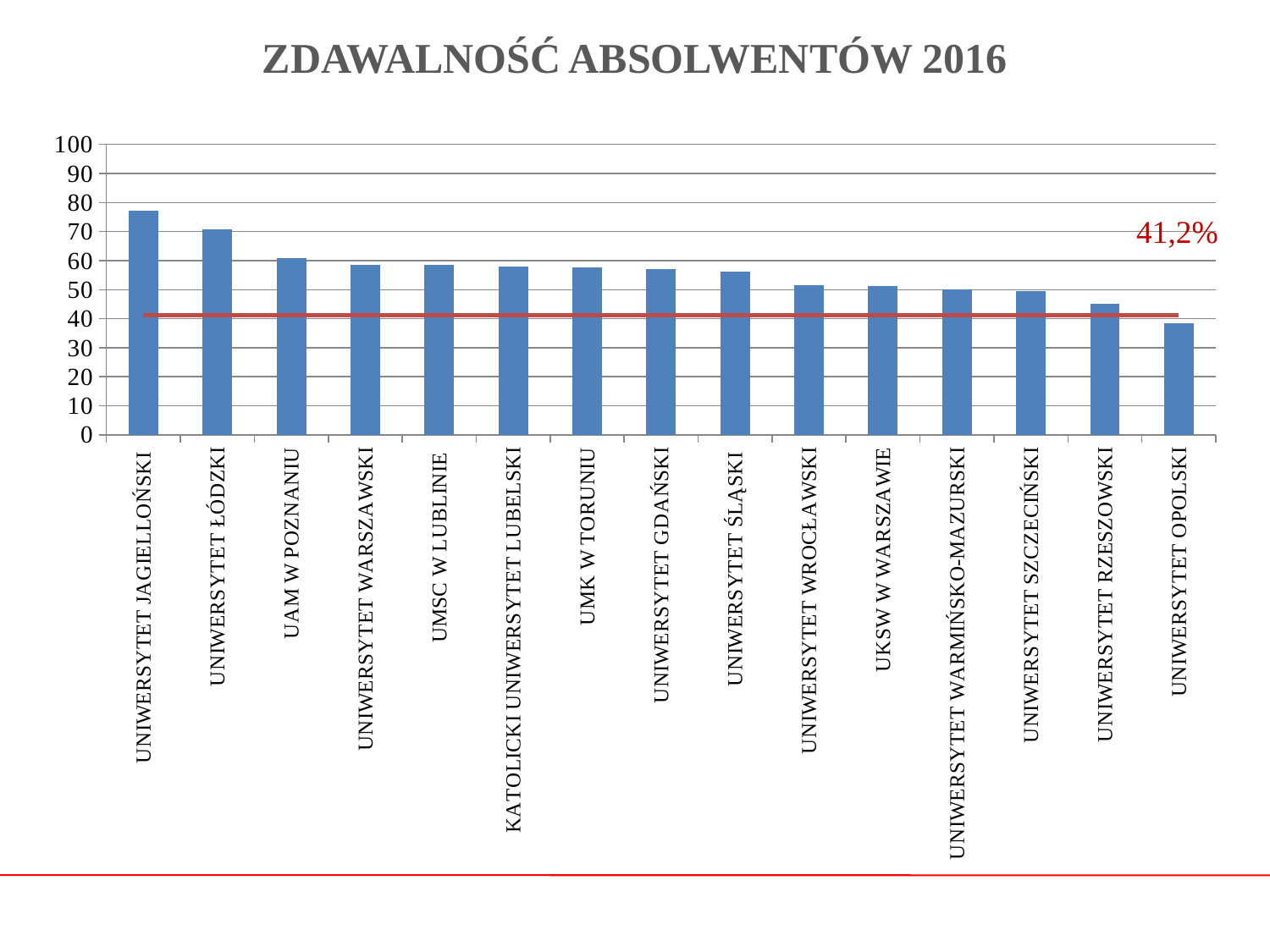
Which university has the highest bar in the chart? UNIWERSYTET JAGIELLOŃSKI Is the value for UNIWERSYTET JAGIELLOŃSKI greater or less than 70? greater What is the title of the chart? ZDAWALNOŚĆ ABSOLWENTÓW 2016 What kind of chart is shown on the slide? bar chart How many universities are shown on the x axis of the chart? 15 Is the value for UNIWERSYTET RZESZOWSKI greater or less than 50? less Do the bar values generally rise or fall from left to right along the x axis? fall What value is printed in red next to the horizontal red line on the chart? 41,2% Is the value for UNIWERSYTET OPOLSKI greater or less than 40? less Which university has the lowest bar in the chart? UNIWERSYTET OPOLSKI Which is larger, the value for UNIWERSYTET ŁÓDZKI or the value for UNIWERSYTET GDAŃSKI? UNIWERSYTET ŁÓDZKI